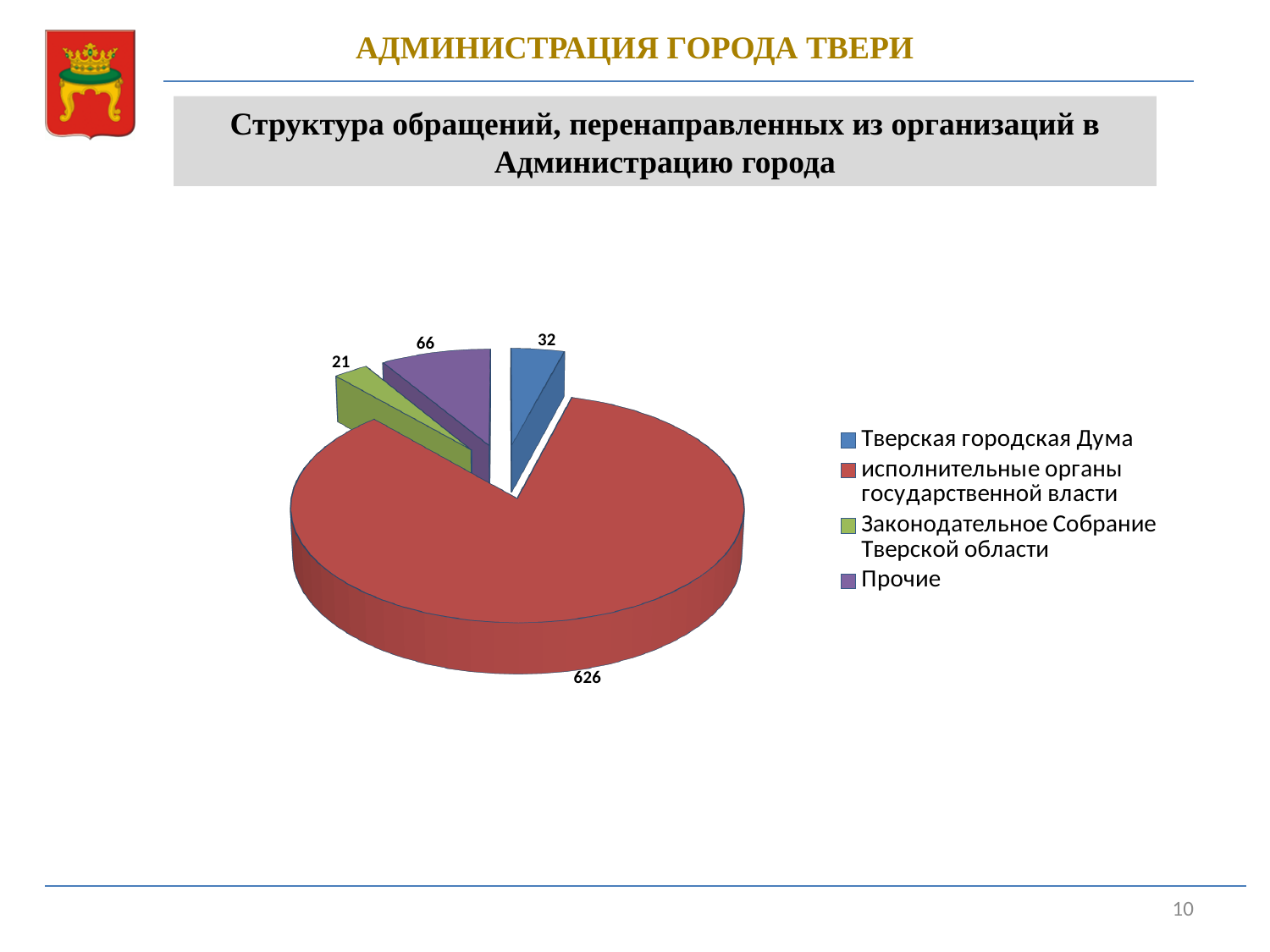
What type of chart is shown on the slide? Pie chart What is the total of all slices in the pie chart? 745 How many slices does the pie chart have? 4 What is the value for Тверская городская Дума? 32 Which category has the smallest slice of the pie? Законодательное Собрание Тверской области What is the value for Законодательное Собрание Тверской области? 21 What is the difference between the values for Прочие and Тверская городская Дума? 34 What is the value for Прочие? 66 What is the value for исполнительные органы государственной власти? 626 Which is larger: the value for Прочие or the value for Тверская городская Дума? Прочие What colour is the slice for исполнительные органы государственной власти? Red Which category has the largest slice of the pie? исполнительные органы государственной власти